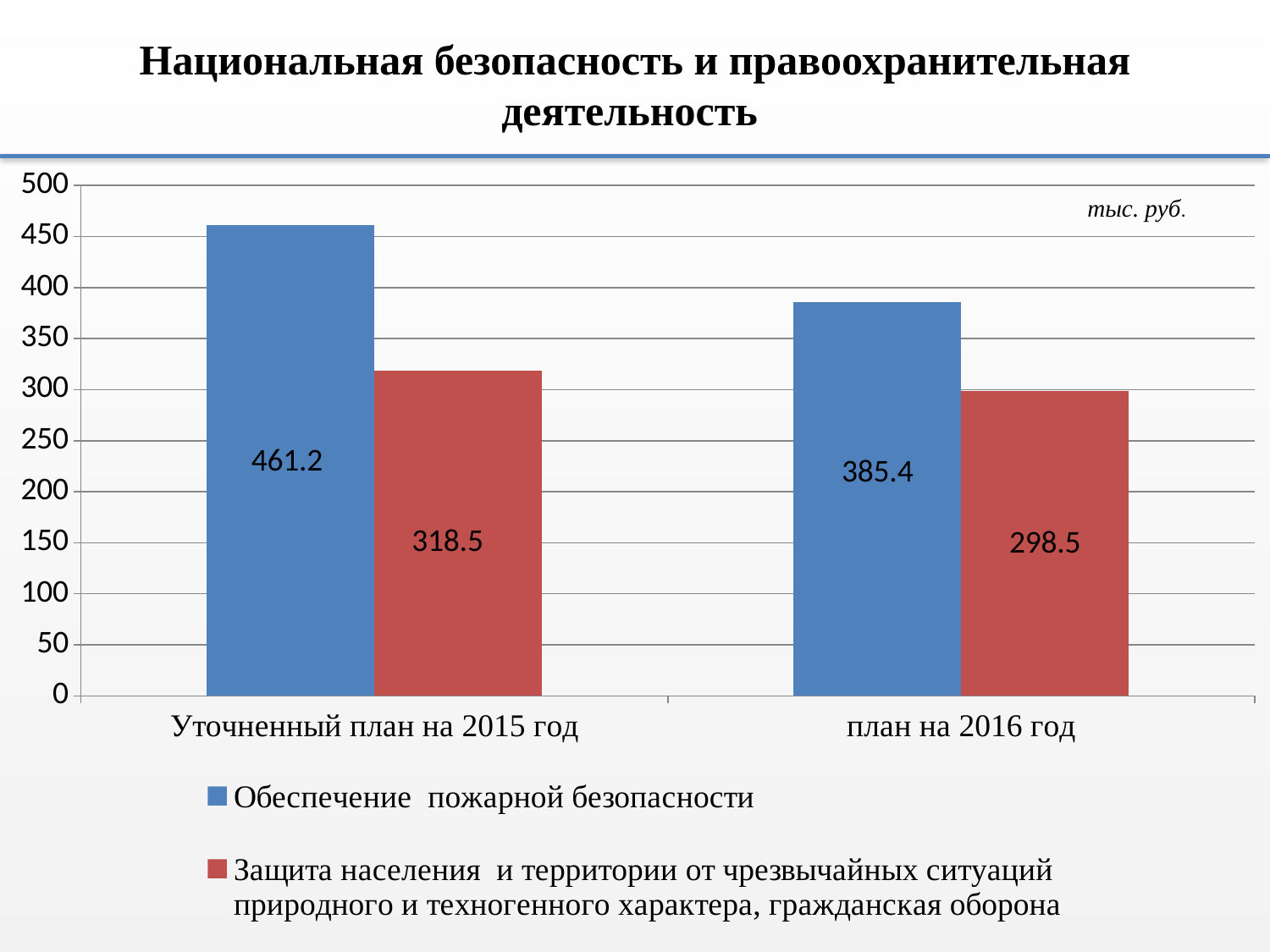
What is the value for "Обеспечение пожарной безопасности" in "Уточненный план на 2015 год"? 461.2 What kind of chart is shown on the slide? Bar chart What is the value for "Защита населения и территории от чрезвычайных ситуаций природного и техногенного характера, гражданская оборона" in "Уточненный план на 2015 год"? 318.5 How many series does the legend list? 2 Which is larger in "план на 2016 год": "Обеспечение пожарной безопасности" or "Защита населения и территории от чрезвычайных ситуаций природного и техногенного характера, гражданская оборона"? Обеспечение пожарной безопасности Which category has the lowest value for "Защита населения и территории от чрезвычайных ситуаций природного и техногенного характера, гражданская оборона"? план на 2016 год What is the difference between the "Обеспечение пожарной безопасности" values for "Уточненный план на 2015 год" and "план на 2016 год"? 75.8 What is the value for "Защита населения и территории от чрезвычайных ситуаций природного и техногенного характера, гражданская оборона" in "план на 2016 год"? 298.5 How many categories are shown on the x axis? 2 What unit is indicated in the top right corner of the chart? тыс. руб. Which category has the highest value for "Обеспечение пожарной безопасности"? Уточненный план на 2015 год What is the value for "Обеспечение пожарной безопасности" in "план на 2016 год"? 385.4